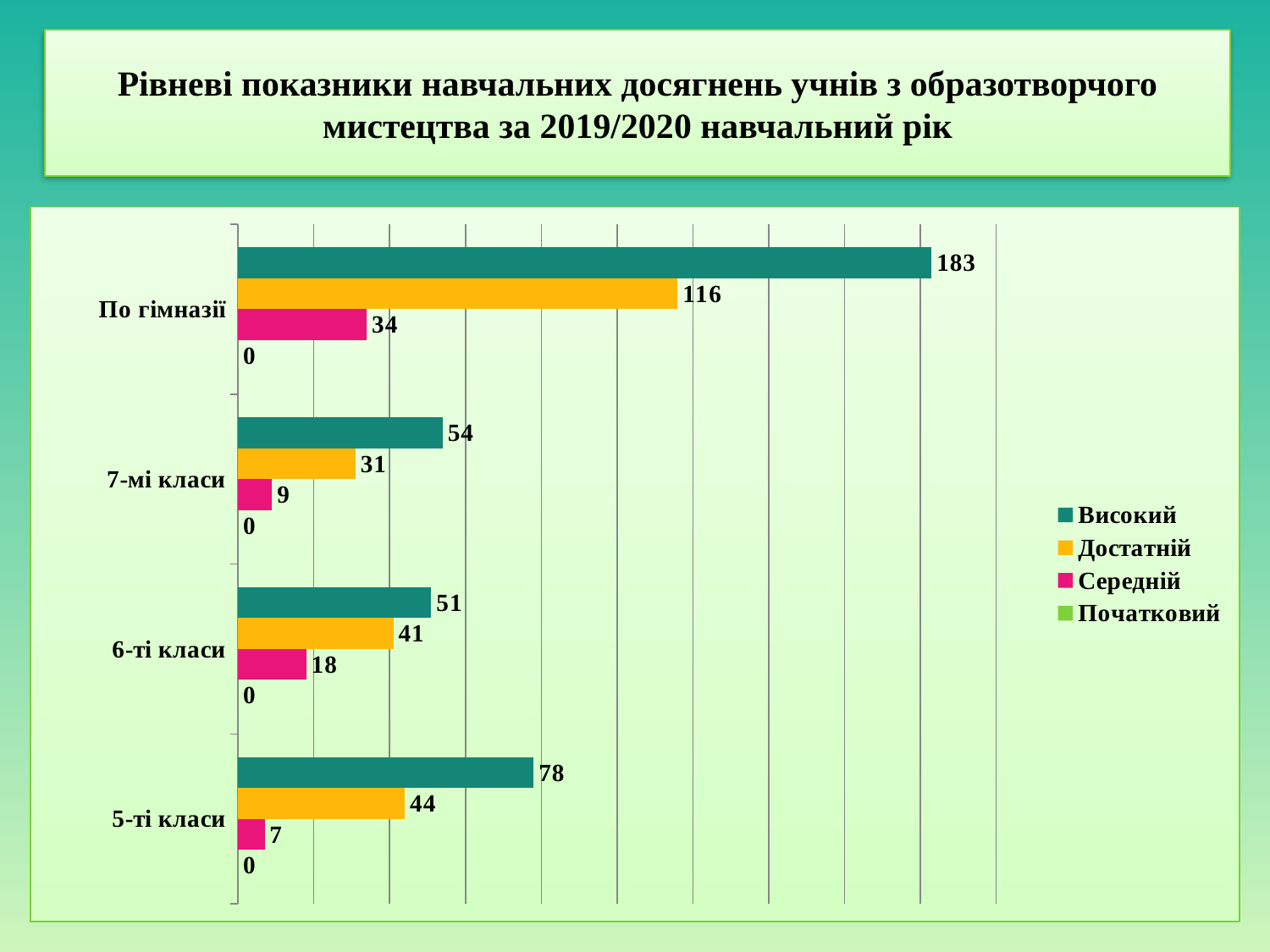
What is the value for Достатній for 6-ті класи? 41 What is the value for Високий for По гімназії? 183 How many series does the legend list? 4 Among the class groups 5-ті класи, 6-ті класи and 7-мі класи, which has the lowest Середній value? 5-ті класи Among the class groups 5-ті класи, 6-ті класи and 7-мі класи, which has the highest Високий value? 5-ті класи What is the value for Початковий for 7-мі класи? 0 What kind of chart is shown on the slide? Bar chart How many categories are shown on the vertical axis? 4 What is the value for Середній for 5-ті класи? 7 Which legend entry is shown in pink? Середній Which is larger: the Достатній value for 7-мі класи or the Достатній value for 5-ті класи? 5-ті класи What is the difference between the Високий and Достатній values for По гімназії? 67